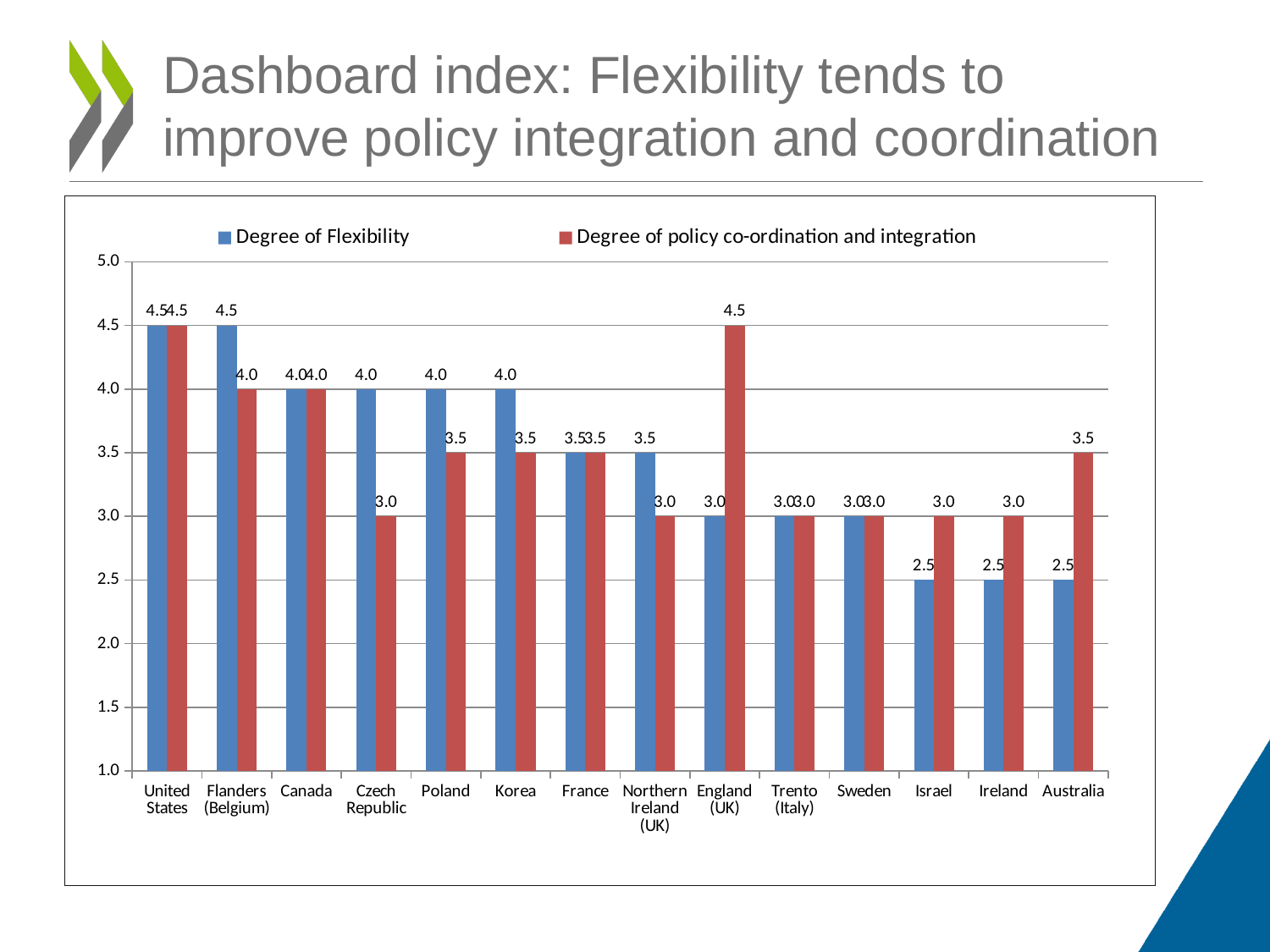
What is the Degree of policy co-ordination and integration value for England (UK)? 4.5 For Israel, which is larger: the Degree of Flexibility or the Degree of policy co-ordination and integration? Degree of policy co-ordination and integration What kind of chart is shown on the slide? Bar chart What is the difference between the Degree of Flexibility and the Degree of policy co-ordination and integration for the Czech Republic? 1.0 How many series does the legend list? 2 What is the Degree of Flexibility value for Australia? 2.5 Do the Degree of Flexibility values rise or fall moving from left to right along the x axis? Fall How many countries or regions are shown on the x axis of the chart? 14 What is the Degree of policy co-ordination and integration value for Flanders (Belgium)? 4.0 What is the Degree of Flexibility value for the Czech Republic? 4.0 What is the difference between the Degree of Flexibility and the Degree of policy co-ordination and integration for England (UK)? 1.5 For Poland, which is larger: the Degree of Flexibility or the Degree of policy co-ordination and integration? Degree of Flexibility